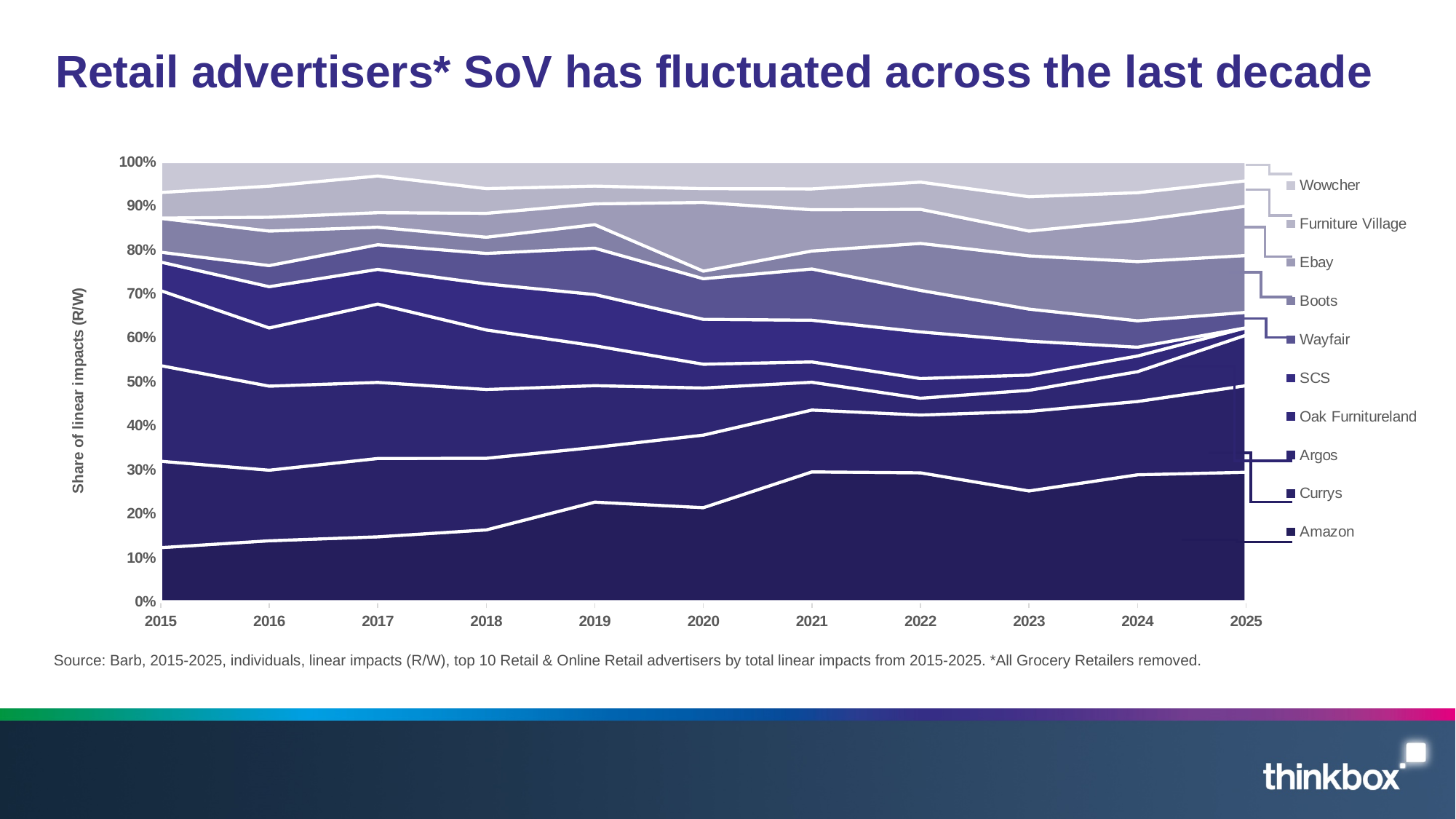
How many years are shown along the x axis? 11 What is the first year shown on the x axis? 2015 Does Amazon's share of linear impacts rise or fall between 2015 and 2025? rise Is Amazon's share of linear impacts in 2015 greater or less than 20%? less Is Amazon's share of linear impacts larger in 2025 or in 2015? 2025 Is Amazon's share of linear impacts in 2025 greater or less than 20%? greater How many advertisers does the legend list? 10 What kind of chart is shown on the slide? Stacked area chart In which year is Amazon's share of linear impacts lowest? 2015 Is Amazon's share of linear impacts in 2018 greater or less than 20%? less Which advertiser is the bottom layer of the chart? Amazon What is the title of the chart on the slide? Retail advertisers* SoV has fluctuated across the last decade